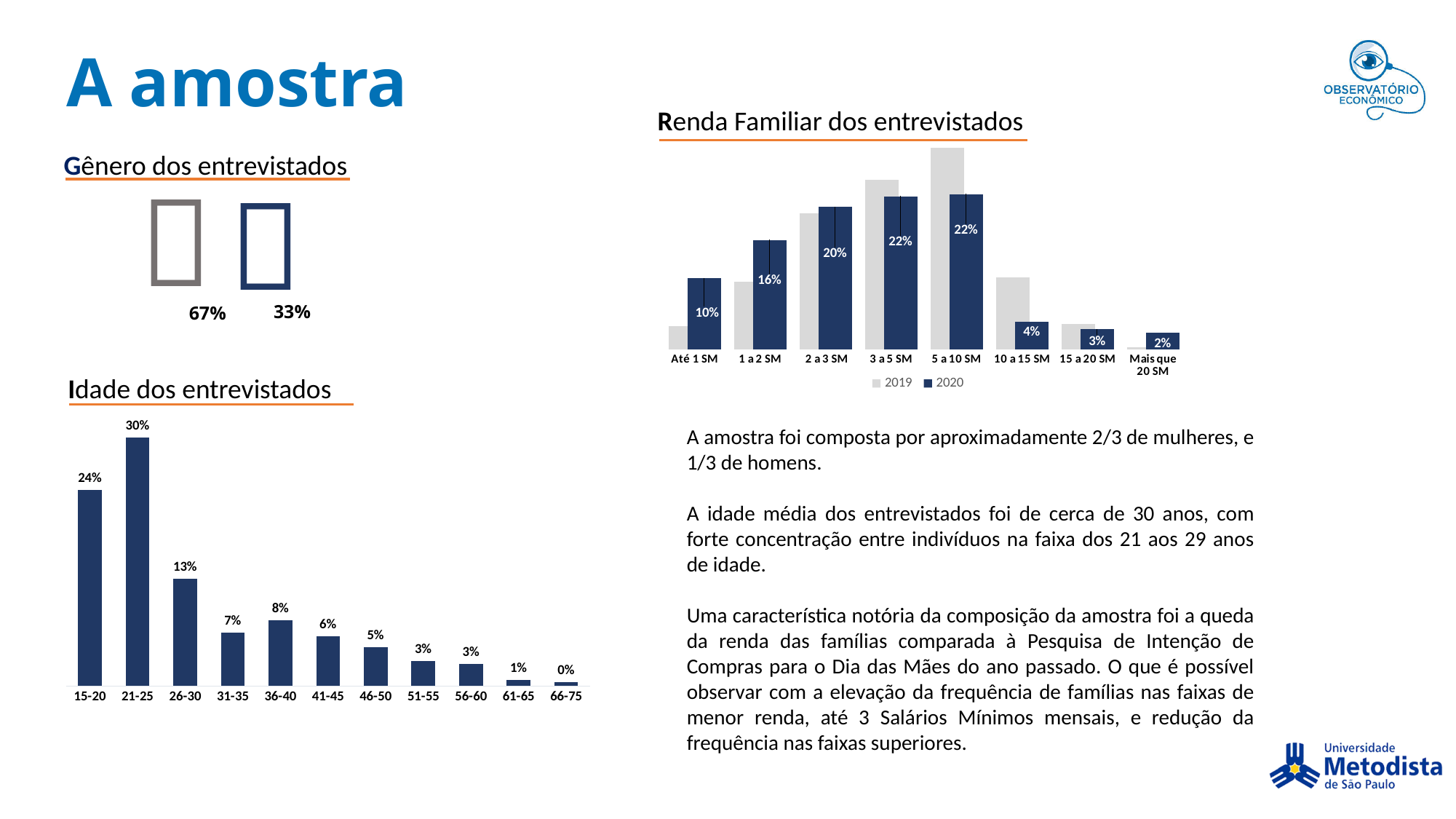
In the 'Renda Familiar dos entrevistados' chart, what is the 2020 value for '1 a 2 SM'? 16% How many series does the legend of the 'Renda Familiar dos entrevistados' chart list? 2 In the 'Idade dos entrevistados' chart, what is the value for the 21-25 age group? 30% In the 'Idade dos entrevistados' chart, which age group has the lowest value? 66-75 In the 'Idade dos entrevistados' chart, what is the difference between the values for 15-20 and 26-30? 11% In the 'Idade dos entrevistados' chart, which is larger, the value for 31-35 or the value for 36-40? 36-40 What kind of chart is 'Idade dos entrevistados'? Bar chart In the 'Idade dos entrevistados' chart, which age group has the highest value? 21-25 In the 'Renda Familiar dos entrevistados' chart, what is the difference between the 2020 values for '2 a 3 SM' and '10 a 15 SM'? 16% How many age groups are shown in the 'Idade dos entrevistados' chart? 11 In the 'Renda Familiar dos entrevistados' chart, for 'Até 1 SM', which series has the larger value, 2019 or 2020? 2020 In the 'Renda Familiar dos entrevistados' chart, which income range has the lowest 2020 value? Mais que 20 SM